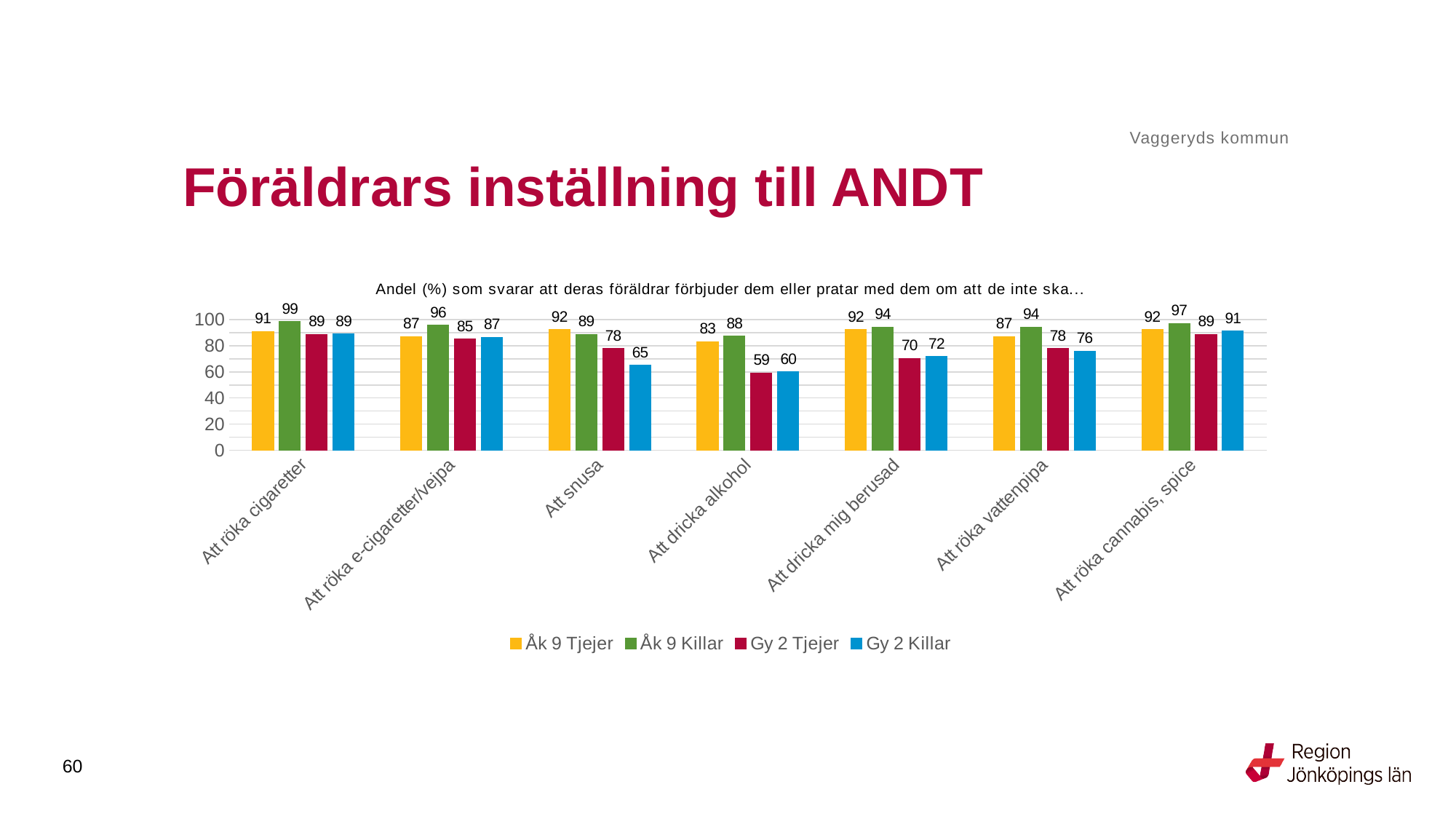
What kind of chart is shown on the slide? Bar chart Which is larger for 'Att dricka mig berusad': Gy 2 Tjejer or Gy 2 Killar? Gy 2 Killar How many series does the legend list? 4 What is the value for Gy 2 Tjejer for 'Att dricka alkohol'? 59 What is the value for Åk 9 Tjejer for 'Att röka vattenpipa'? 87 What is the difference between Åk 9 Tjejer and Gy 2 Killar for 'Att snusa'? 27 Which category has the lowest value for Gy 2 Killar? Att dricka alkohol Which category has the highest value for Åk 9 Killar? Att röka cigaretter What is the value for Gy 2 Killar for 'Att snusa'? 65 What is the value for Åk 9 Killar for 'Att röka cigaretter'? 99 Which series is shown in green in the legend? Åk 9 Killar How many categories are shown on the x axis? 7